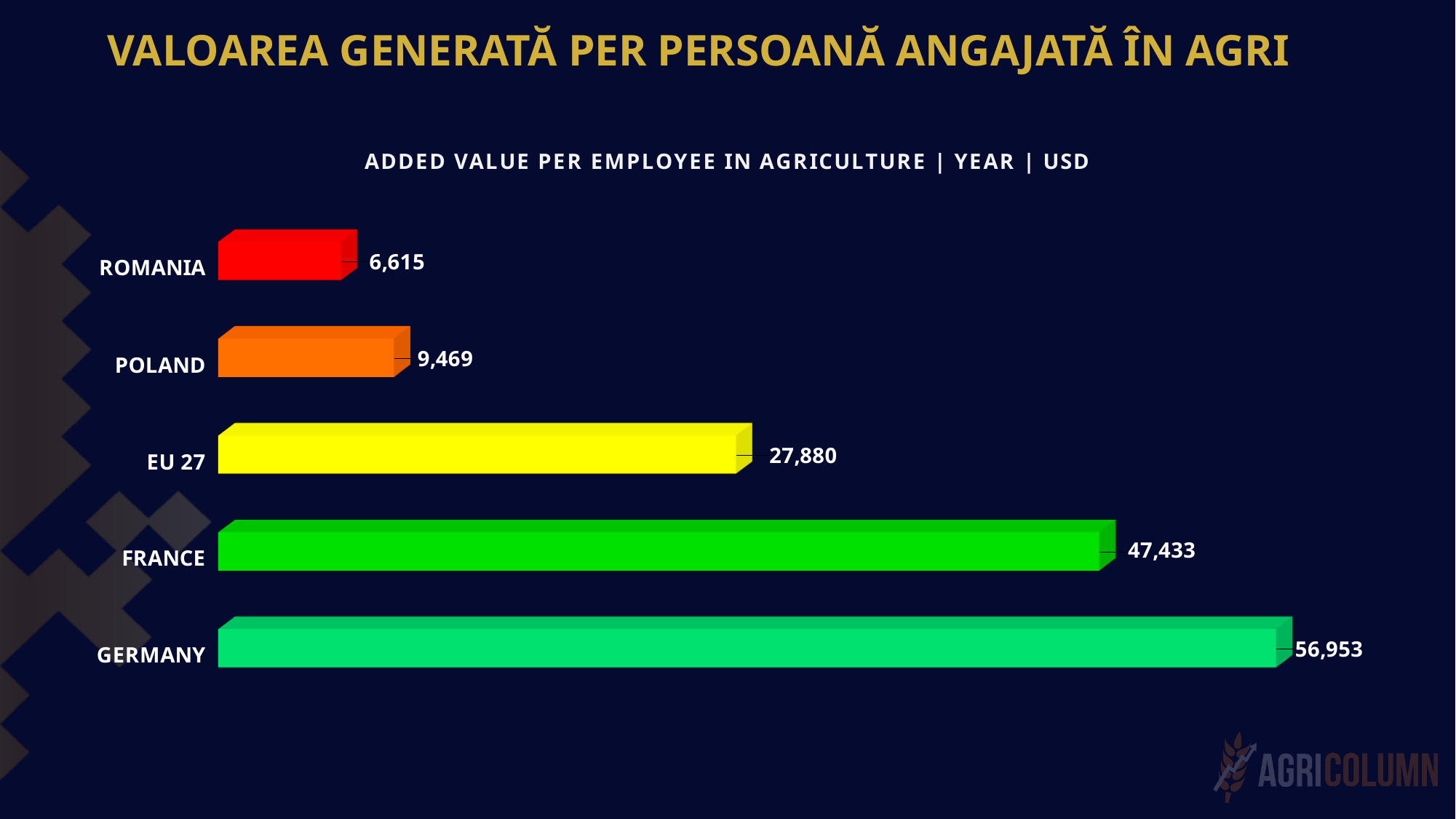
What is the added value per employee in agriculture for Romania? 6,615 What is the difference between Poland's and Romania's added value per employee in agriculture? 2,854 Which category has the lowest added value per employee in agriculture? Romania What kind of chart is shown on the slide? Bar chart What is the added value per employee in agriculture for France? 47,433 Which category has the highest added value per employee in agriculture? Germany What is the added value per employee in agriculture for Germany? 56,953 What is the added value per employee in agriculture for Poland? 9,469 What is the difference between Germany's and France's added value per employee in agriculture? 9,520 How many categories are shown in the chart? 5 Which has a larger added value per employee in agriculture, EU 27 or Poland? EU 27 What is the added value per employee in agriculture for EU 27? 27,880